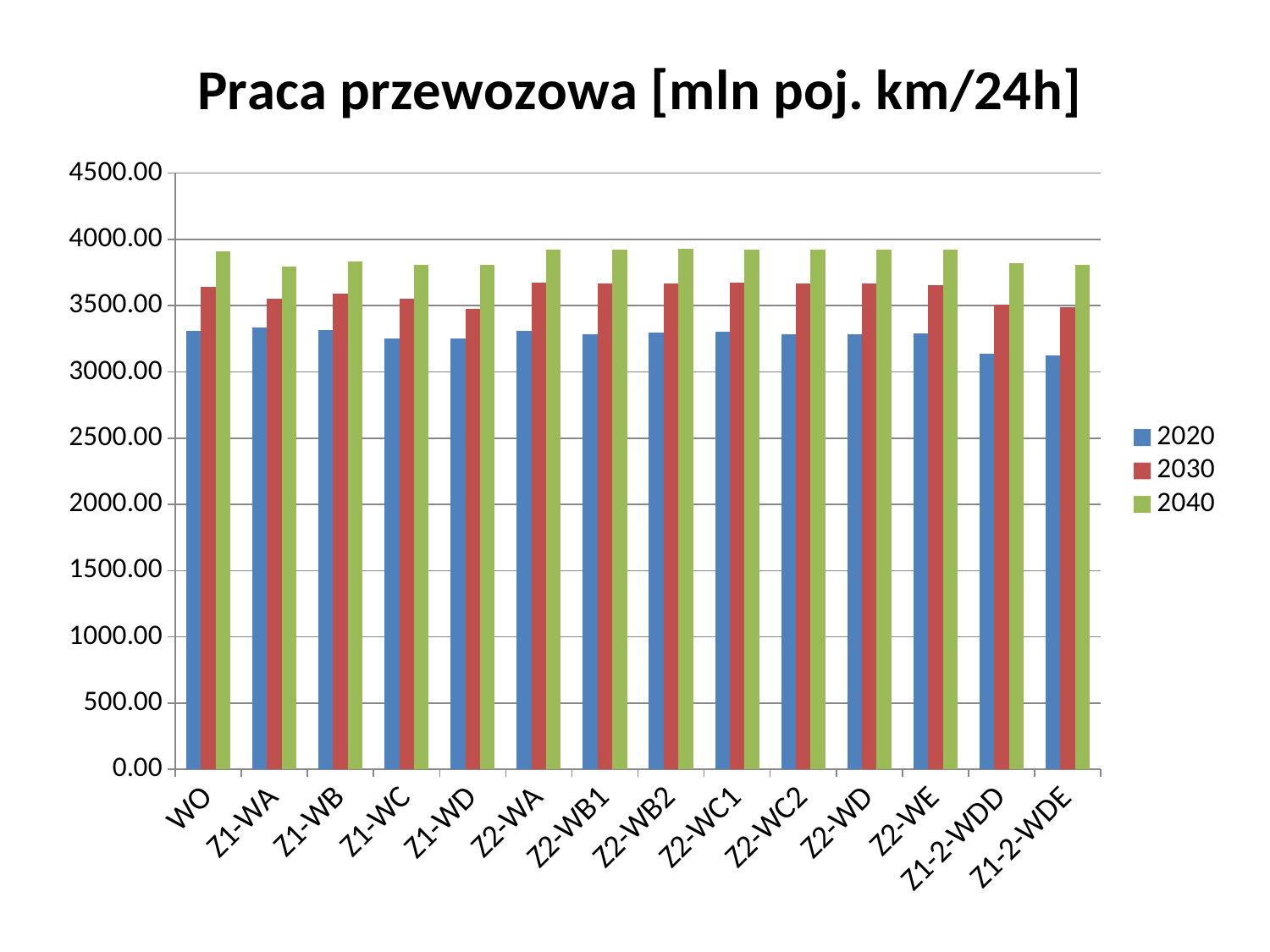
What is the title of the chart? Praca przewozowa [mln poj. km/24h] Which series is shown in green in the legend? 2040 Is the 2030 value for WO greater or less than 3500? greater How many categories are shown on the x axis? 14 Is the 2040 value for WO greater or less than 3500? greater Is the 2020 value for WO greater or less than 3000? greater What kind of chart is shown on the slide? bar chart Which is larger, the 2020 value for Z1-WA or the 2020 value for Z1-2-WDE? Z1-WA Within each category, do the values rise or fall from the 2020 series to the 2040 series? rise How many series does the legend list? 3 For the category Z2-WA, which series has the larger value, 2020 or 2040? 2040